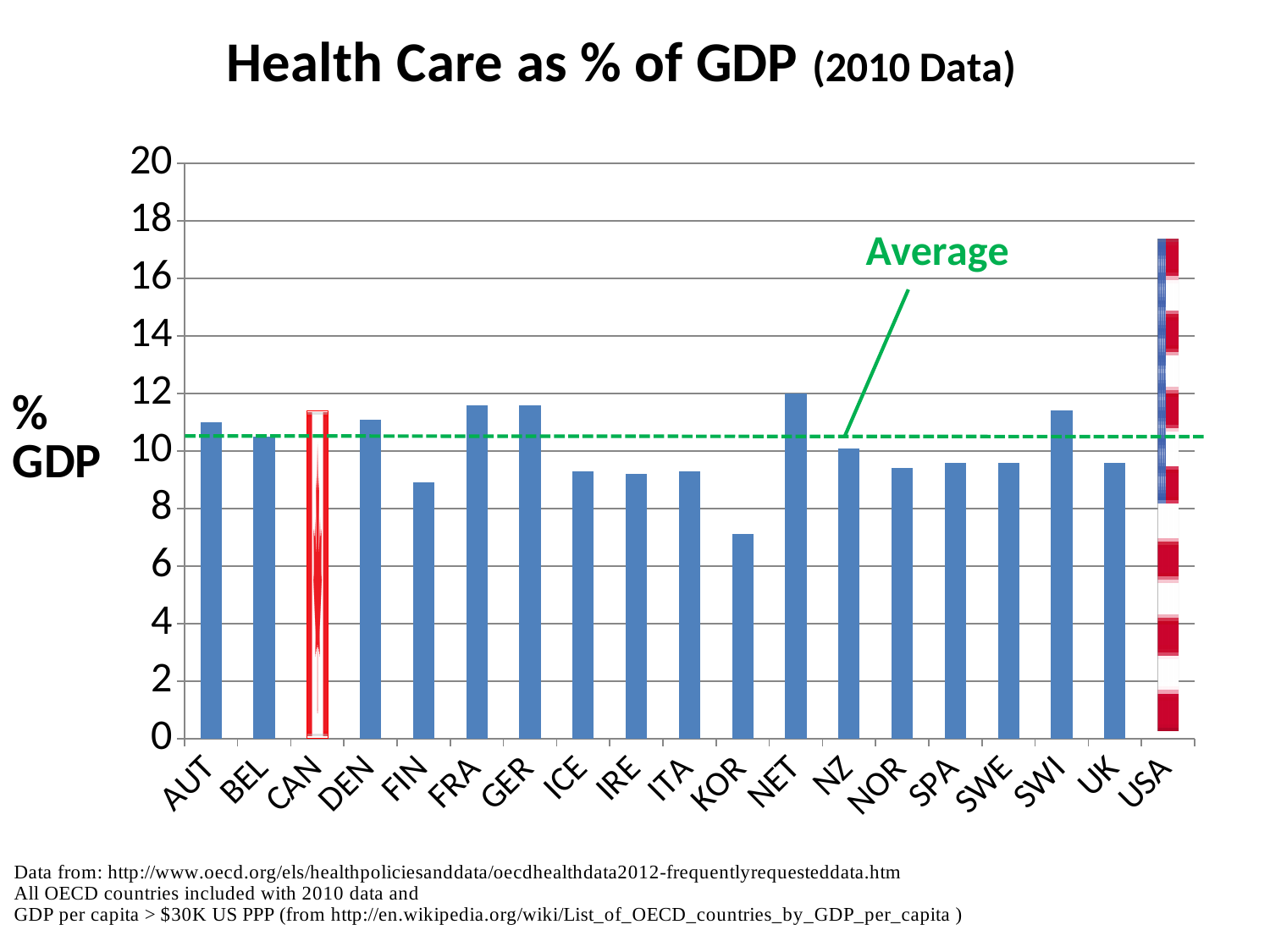
How many countries are shown on the x axis? 19 What kind of chart is shown on the slide? bar chart Is the value for NET greater or less than 10? greater Which country has the lowest health care spending as % of GDP? KOR What is the title of the chart? Health Care as % of GDP (2010 Data) Which country has the highest health care spending as % of GDP? USA Is the value for USA greater or less than 16? greater Which is larger, the value for USA or the value for SWI? USA Is the value for FIN greater or less than 10? less Which is larger, the value for NET or the value for KOR? NET What does the green dashed horizontal line represent? Average